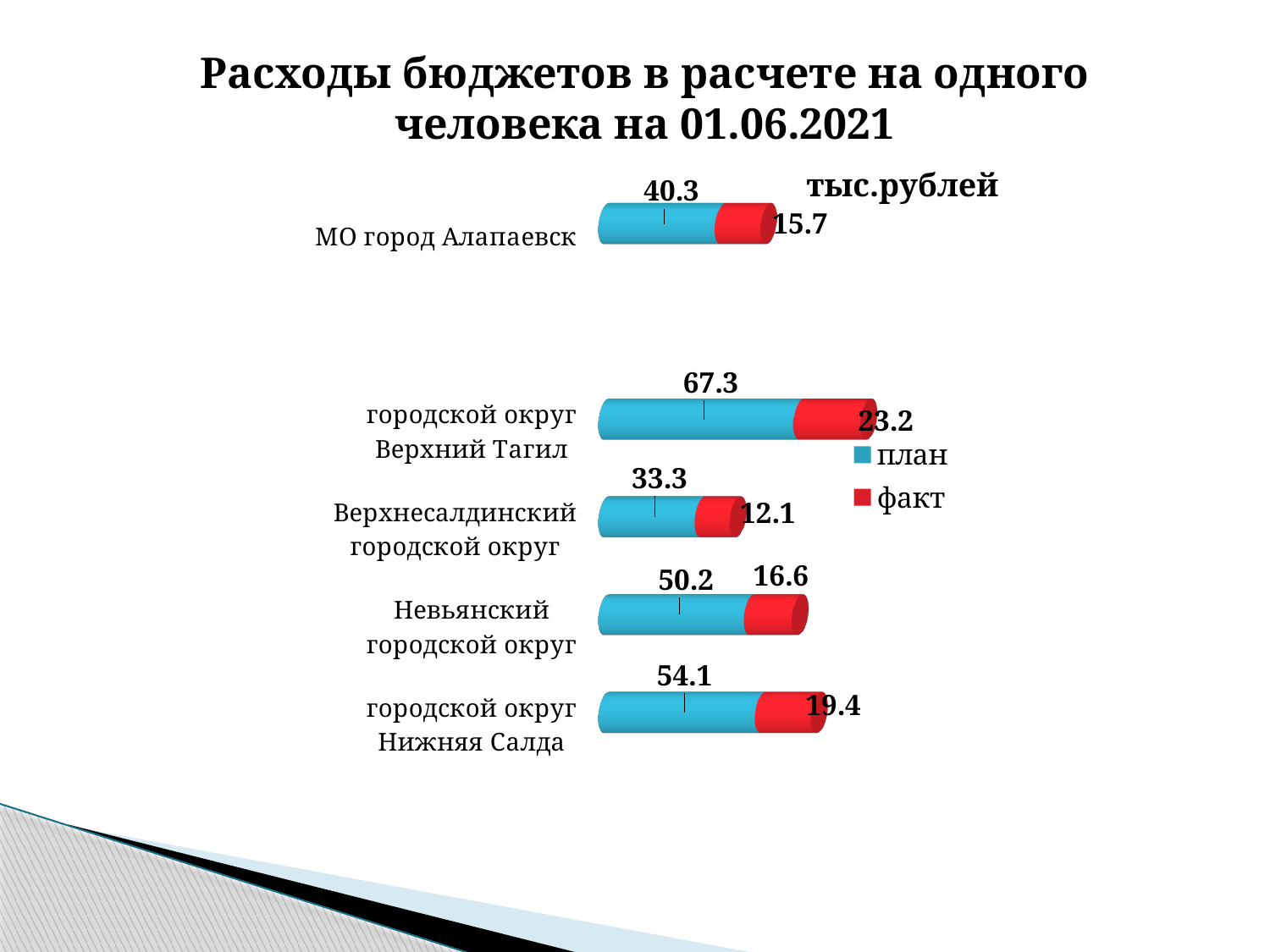
What kind of chart is shown on the slide? Stacked bar chart What is the total of the stacked bar for городской округ Нижняя Салда? 73.5 Which category has the highest план value? городской округ Верхний Тагил Which category has the lowest факт value? Верхнесалдинский городской округ How many series does the legend list? 2 What is the факт value for городской округ Верхний Тагил? 23.2 What is the план value for Невьянский городской округ? 50.2 Which is larger, the факт value for Невьянский городской округ or the факт value for МО город Алапаевск? Невьянский городской округ What is the факт value for городской округ Нижняя Салда? 19.4 What unit is stated for the values in the chart? тыс.рублей What is the difference between the план and факт values for Верхнесалдинский городской округ? 21.2 What is the план value for МО город Алапаевск? 40.3